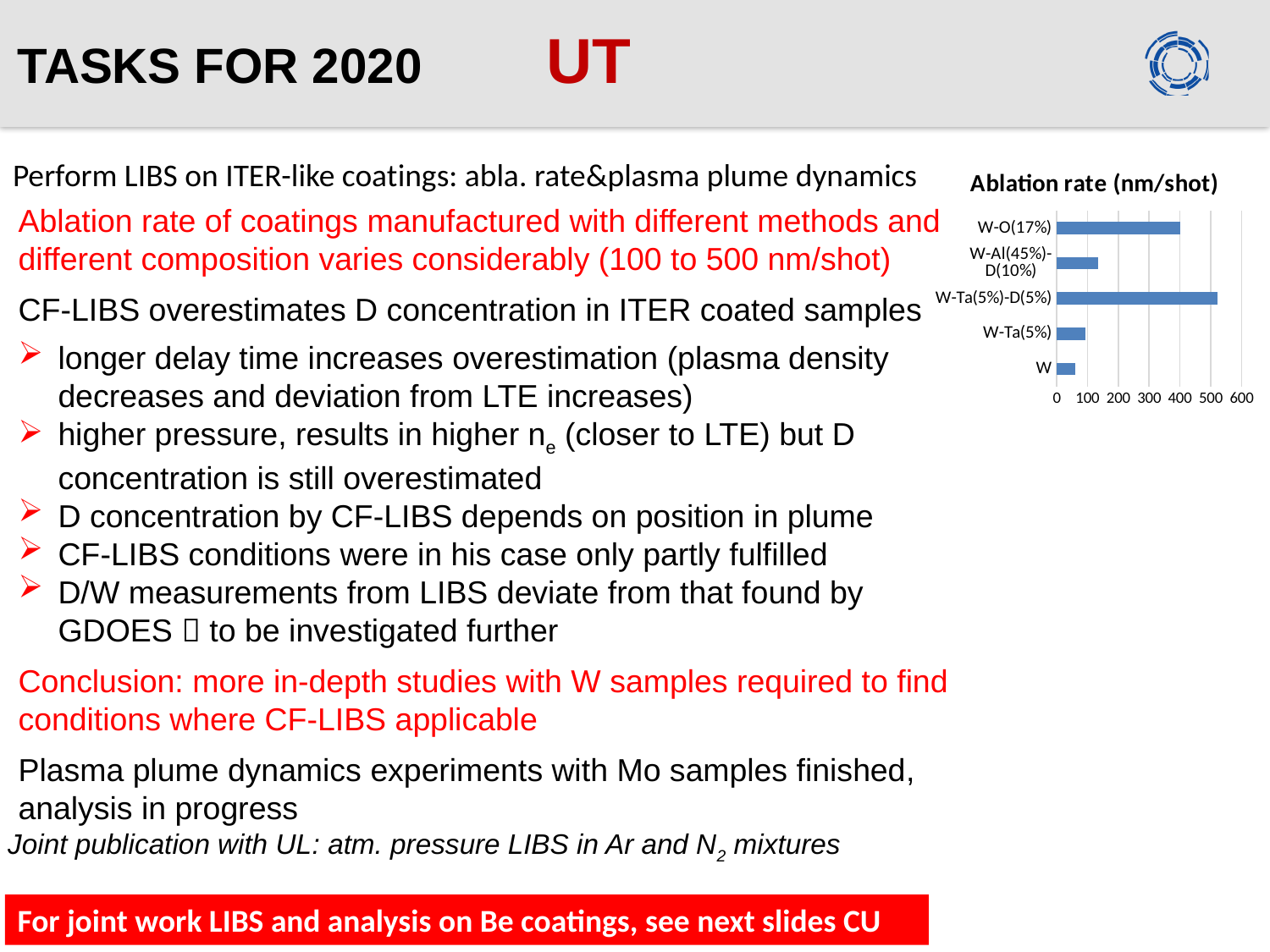
How many categories are plotted in the Ablation rate chart? 5 Which category has the lowest ablation rate? W What kind of chart is shown on the slide? bar chart What is the title of the chart? Ablation rate (nm/shot) Which has a higher ablation rate, W-O(17%) or W-Al(45%)-D(10%)? W-O(17%) Is the ablation rate for W-O(17%) greater or less than 300? greater What is the maximum value shown on the horizontal axis of the chart? 600 Is the ablation rate for W-Ta(5%)-D(5%) greater or less than 400? greater Is the ablation rate for W-Ta(5%) greater or less than 200? less Which category has the highest ablation rate? W-Ta(5%)-D(5%)